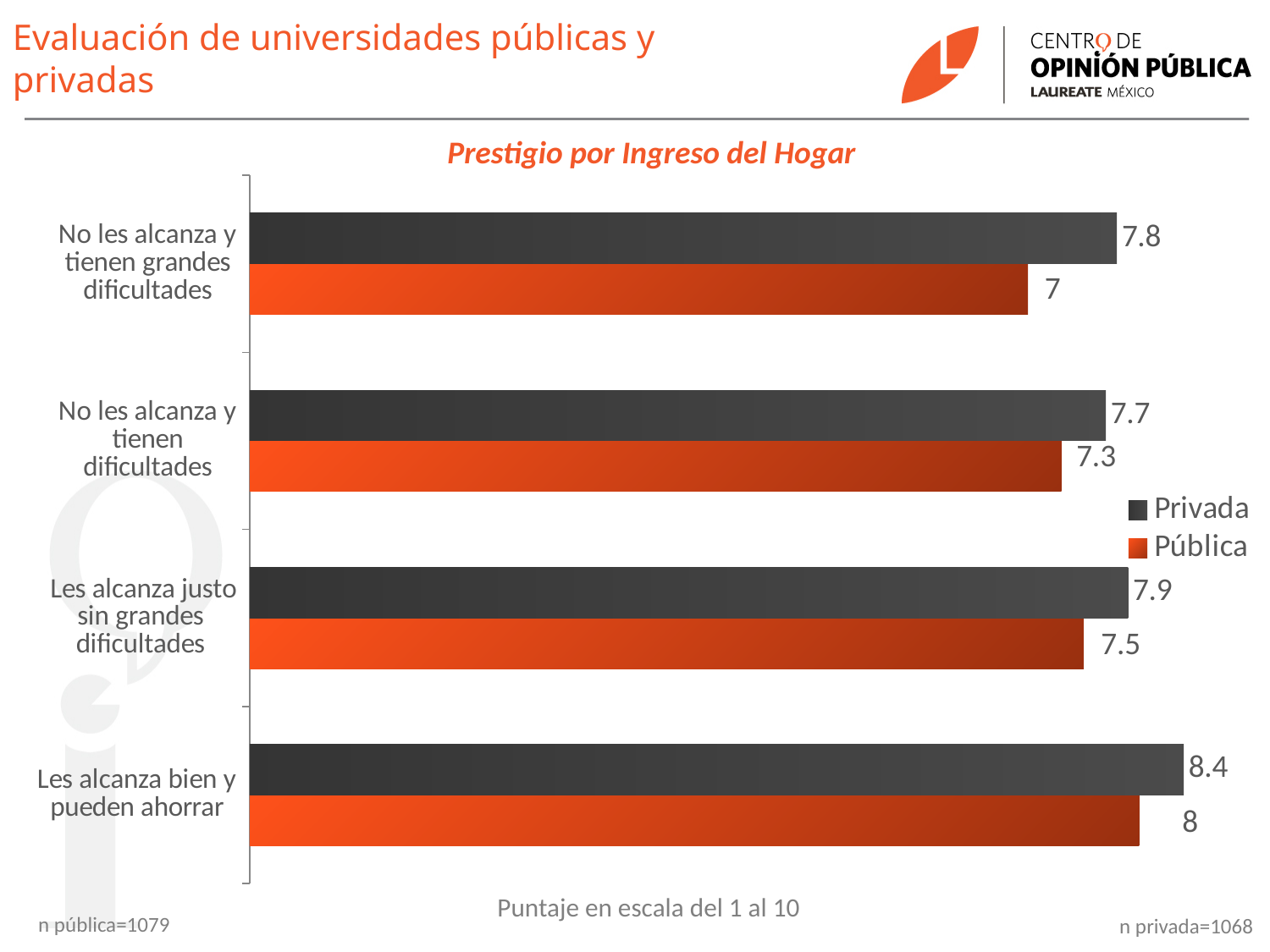
How many income categories are shown in the chart? 4 What is the difference between the Privada and Pública values for 'Les alcanza bien y pueden ahorrar'? 0.4 Which is larger for 'No les alcanza y tienen grandes dificultades': the Privada value or the Pública value? Privada What is the Privada value for 'No les alcanza y tienen dificultades'? 7.7 How many series does the legend list? 2 What is the Privada value for 'Les alcanza bien y pueden ahorrar'? 8.4 What kind of chart is shown on the slide? Bar chart Which category has the lowest Privada value? No les alcanza y tienen dificultades What is the title of the chart? Prestigio por Ingreso del Hogar What is the Pública value for 'Les alcanza justo sin grandes dificultades'? 7.5 Which category has the highest Pública value? Les alcanza bien y pueden ahorrar What is the Pública value for 'No les alcanza y tienen grandes dificultades'? 7